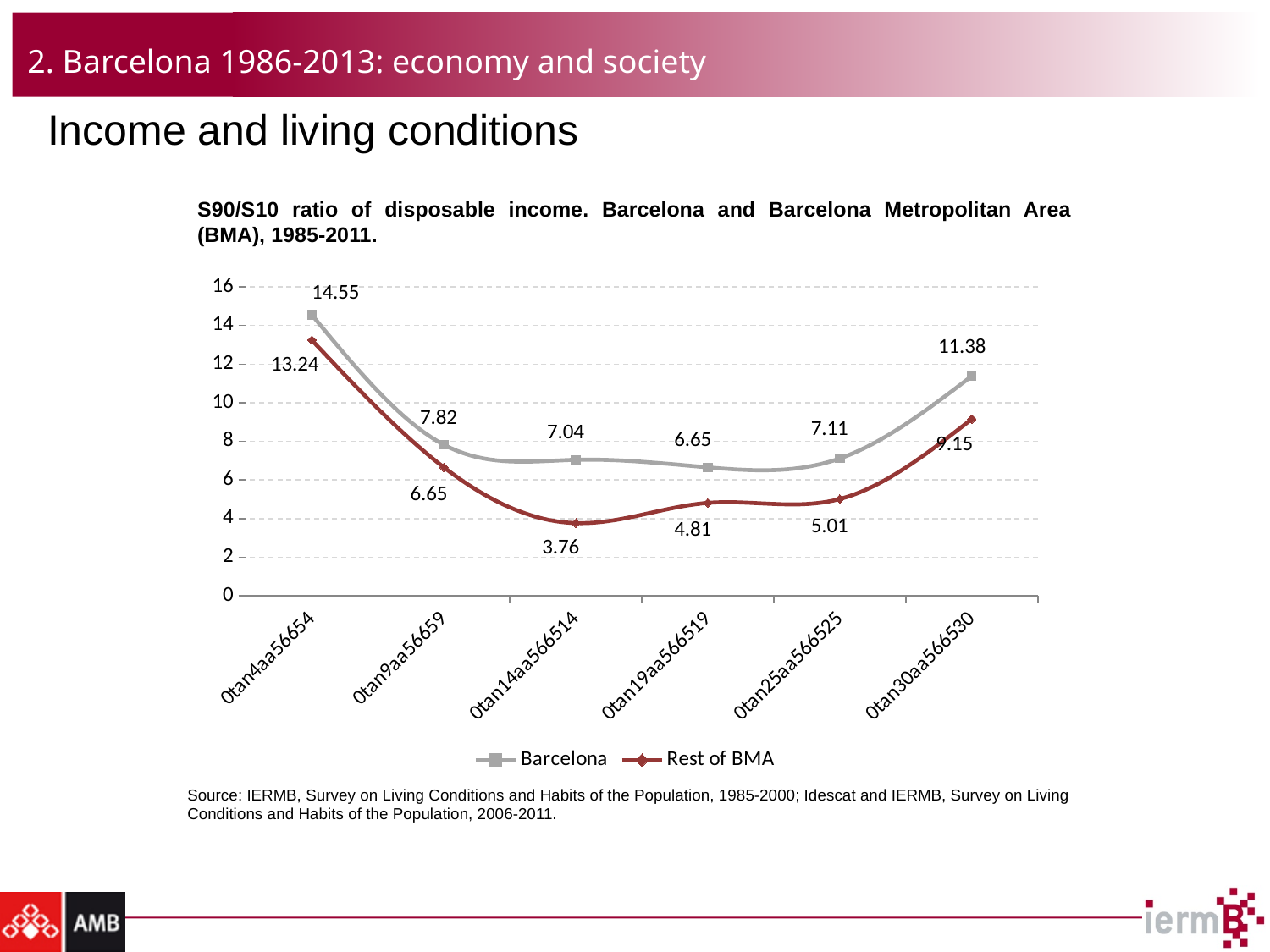
What is the highest value plotted for the Barcelona series? 14.55 How many data points does each series have? 6 How many series does the legend list? 2 What is the Rest of BMA value at the first point on the x axis? 13.24 Does the Barcelona series rise or fall between the first and second points on the x axis? Fall What is the difference between the Barcelona and Rest of BMA values at the first point on the x axis? 1.31 What is the Barcelona value at the last point on the x axis? 11.38 What kind of chart is shown on the slide? Line chart At the third point on the x axis, which series has the larger value, Barcelona or Rest of BMA? Barcelona What is the Barcelona value at the first point on the x axis? 14.55 Which series is drawn in red? Rest of BMA What is the lowest value plotted for the Rest of BMA series? 3.76